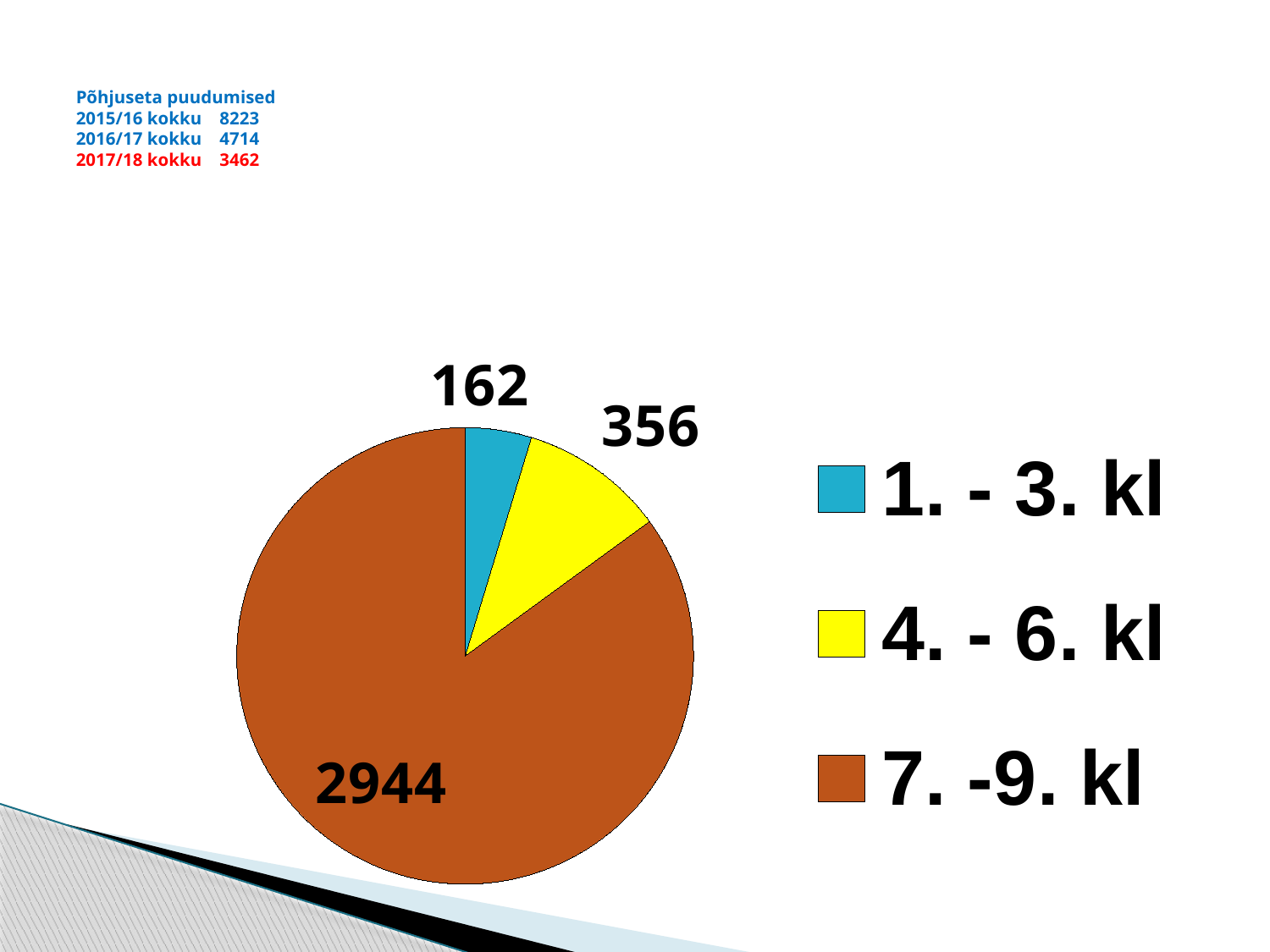
What is the value for the 7. -9. kl slice? 2944 What is the value for the 1. - 3. kl slice? 162 What kind of chart is shown on the slide? pie chart What colour is the slice for 4. - 6. kl? yellow Which category has the smallest slice of the pie? 1. - 3. kl What is the value for the 4. - 6. kl slice? 356 What is the difference between the values for 7. -9. kl and 4. - 6. kl? 2588 How many slices does the pie chart have? 3 Which is larger, the value for 4. - 6. kl or the value for 1. - 3. kl? 4. - 6. kl What is the difference between the values for 4. - 6. kl and 1. - 3. kl? 194 How many entries does the legend list? 3 Which category has the largest slice of the pie? 7. -9. kl